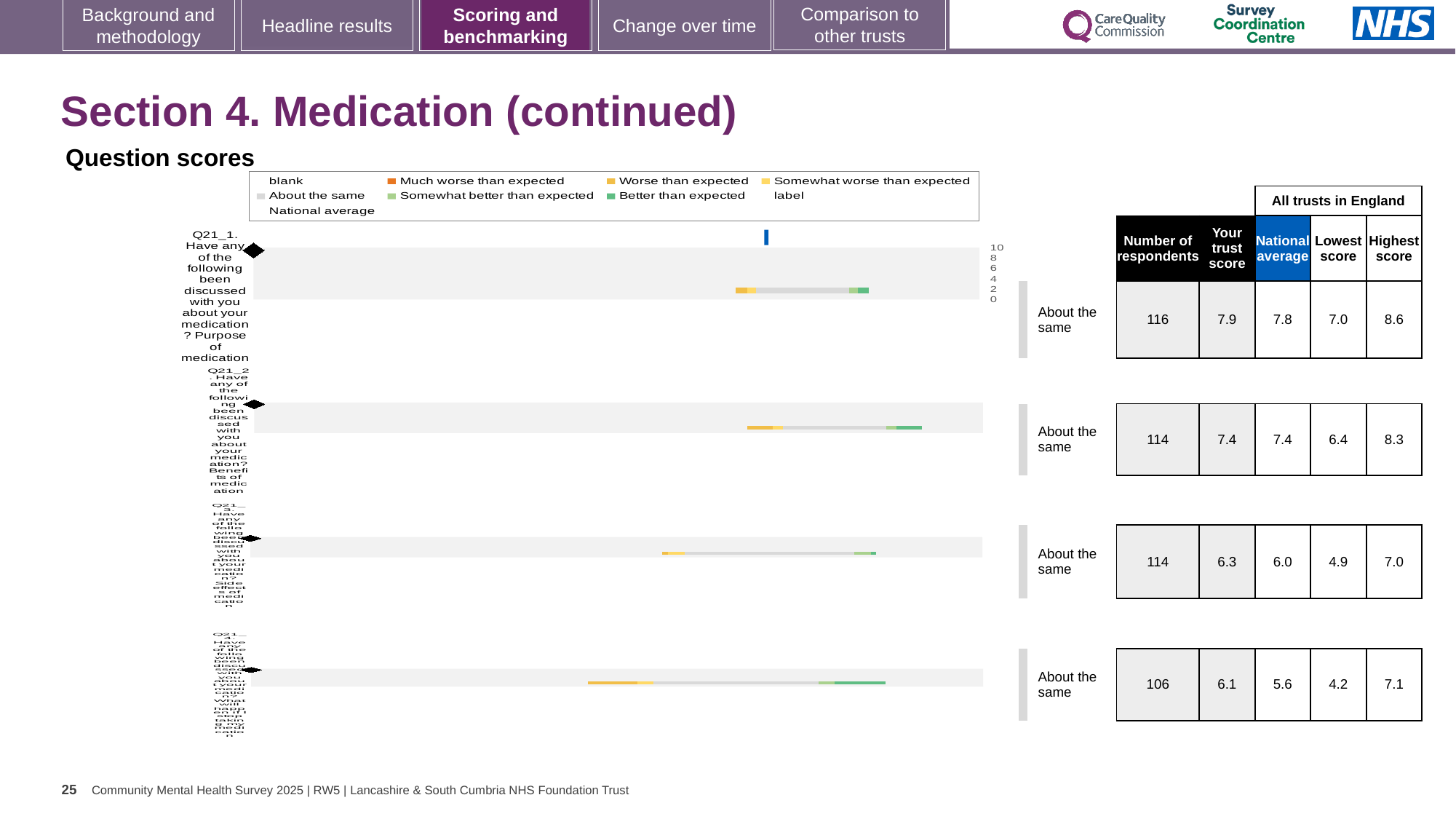
What is the national average for Q21_4 (What might happen if I stop taking medication)? 5.6 How many question bars (Q21_1 to Q21_4) are plotted in the chart? 4 Which has the larger highest score across all trusts in England, Q21_1 or Q21_2? Q21_1 Which question has the lowest 'Lowest score' across all trusts in England? Q21_4 How many respondents answered Q21_2 (Benefits of medication)? 114 What benchmark category is shown next to each of the four question bars? About the same What kind of chart is shown under 'Question scores'? bar chart What is the difference between the highest score and the lowest score across all trusts for Q21_1? 1.6 What is the highest score across all trusts in England for Q21_4? 7.1 What is the difference between 'Your trust score' and the national average for Q21_3 (Side effects of medication)? 0.3 Which question has the highest 'Your trust score'? Q21_1 What is 'Your trust score' for Q21_1 (Purpose of medication)? 7.9